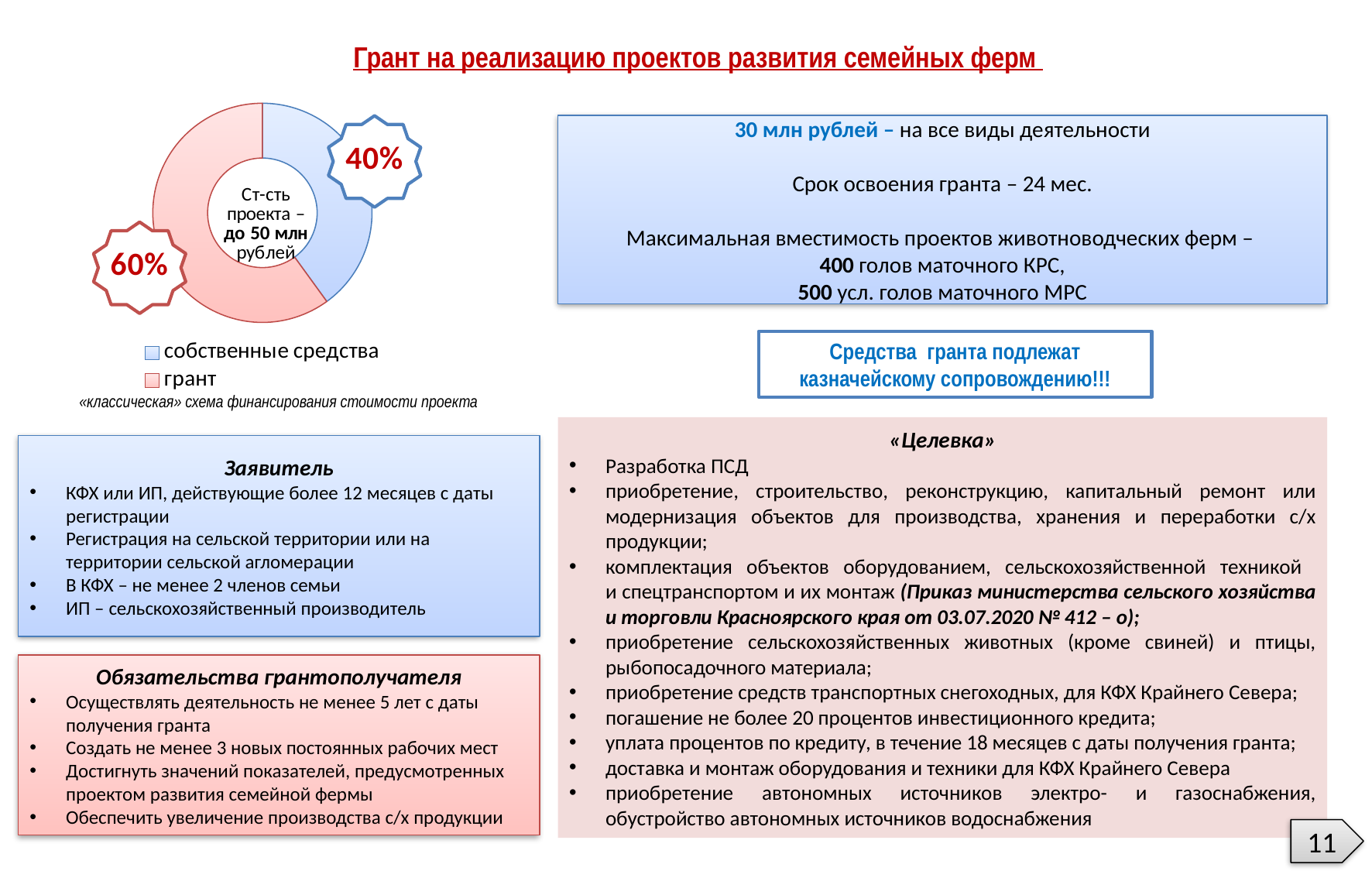
Is the value for "собственные средства" greater or less than 50%? less What colour is the "грант" slice in the chart? Pink (red) Which is larger: the "грант" slice or the "собственные средства" slice? грант What share of the project cost does the "собственные средства" slice represent? 40% What project cost is stated in the centre of the donut chart? до 50 млн рублей How many entries does the chart legend list? 2 What kind of chart is shown on the slide? Pie (donut) chart Which slice of the chart is the largest? грант What share of the project cost does the "грант" slice represent? 60% Which slice of the chart is the smallest? собственные средства How many slices does the chart have? 2 What is the difference in percentage points between the "грант" and "собственные средства" slices? 20%